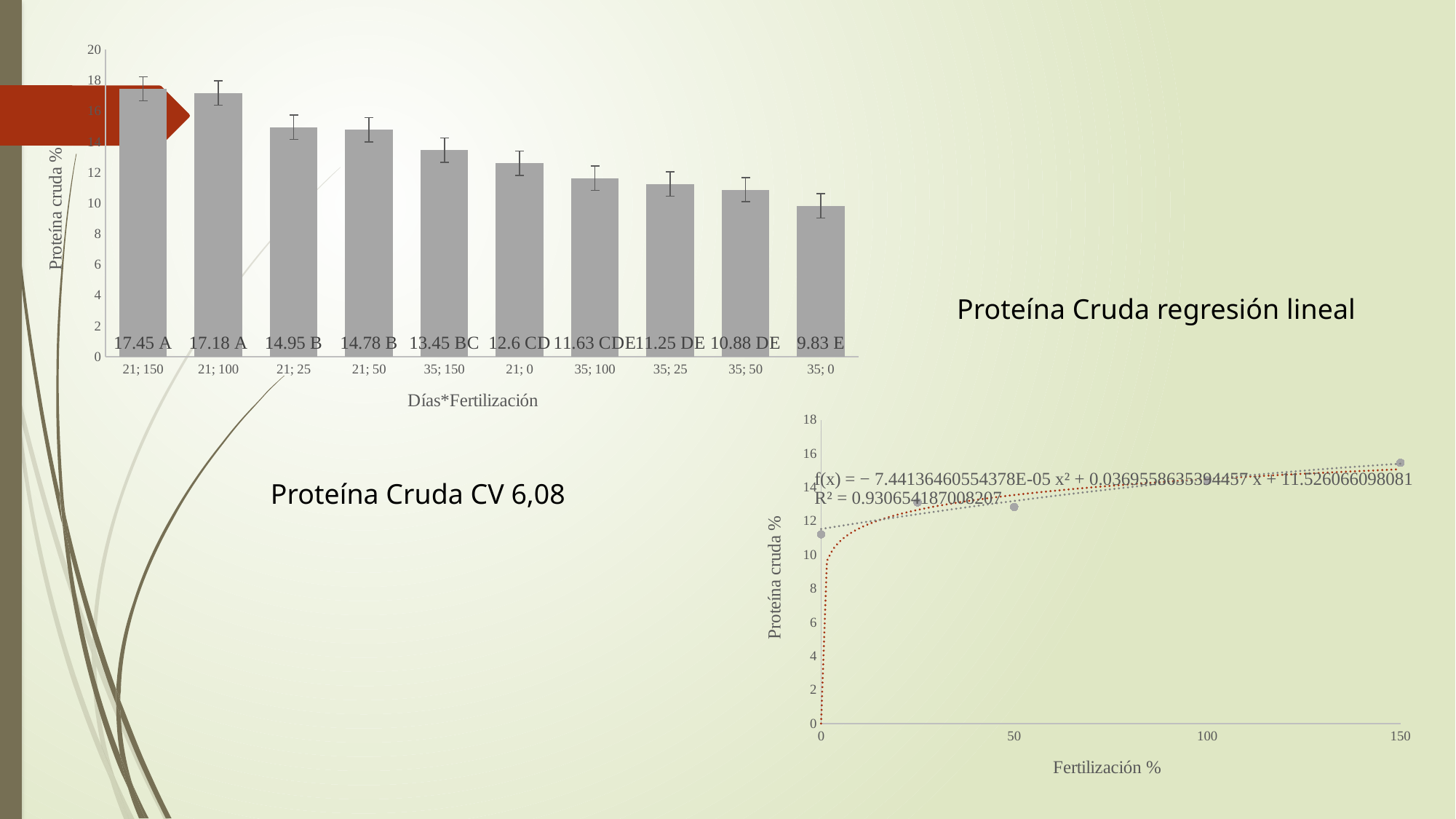
How many bars are in the bar chart on the left? 10 In the bar chart on the left, what is the value for the category 21; 150? 17.45 In the chart titled 'Proteína Cruda regresión lineal', is the value at Fertilización 0 greater or less than 12? less What kind of chart is the chart titled 'Proteína Cruda regresión lineal'? scatter chart In the bar chart on the left, what is the difference between the values for 21; 150 and 35; 0? 7.62 In the bar chart on the left, which is larger, the value for 21; 0 or the value for 35; 100? 21; 0 In the bar chart on the left, which category has the lowest value? 35; 0 In the bar chart on the left, which category has the highest value? 21; 150 In the bar chart on the left, what is the value for the category 35; 150? 13.45 In the bar chart on the left, what is the x-axis title? Días*Fertilización In the chart titled 'Proteína Cruda regresión lineal', is the value at Fertilización 150 greater or less than 14? greater In the bar chart on the left, what is the value for the category 35; 0? 9.83